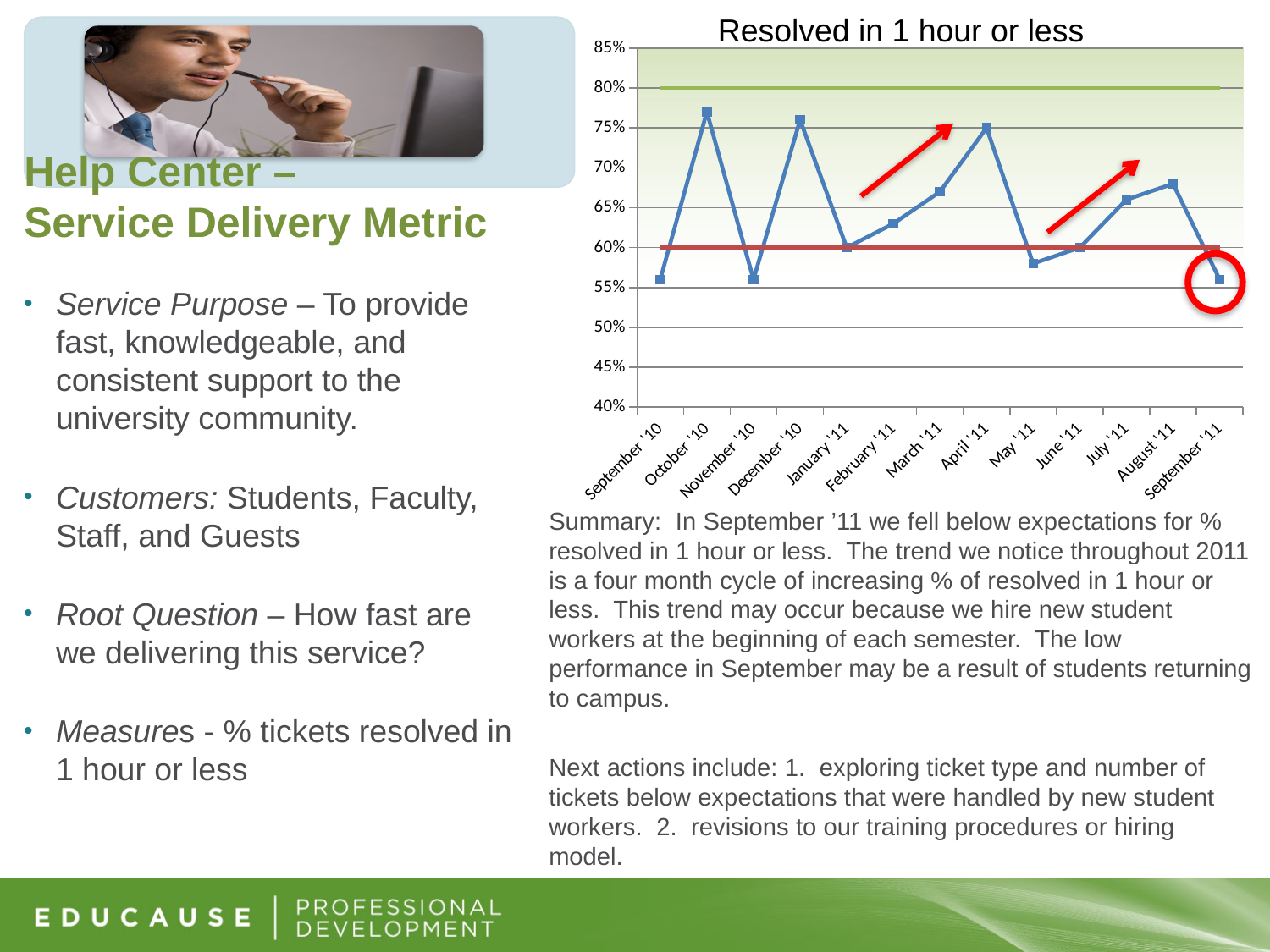
Which month has the higher value, September '10 or October '10? October '10 How many months are plotted along the x axis of the chart? 13 At what percentage is the green horizontal reference line drawn on the chart? 80% Is the value for August '11 greater or less than 70%? less Is the value for October '10 greater or less than 75%? greater Is the value for September '11 greater or less than 60%? less Do the values rise or fall from January '11 to April '11? rise Which month has the higher value, April '11 or May '11? April '11 What is the title of the chart? Resolved in 1 hour or less What kind of chart is shown on the slide? line chart